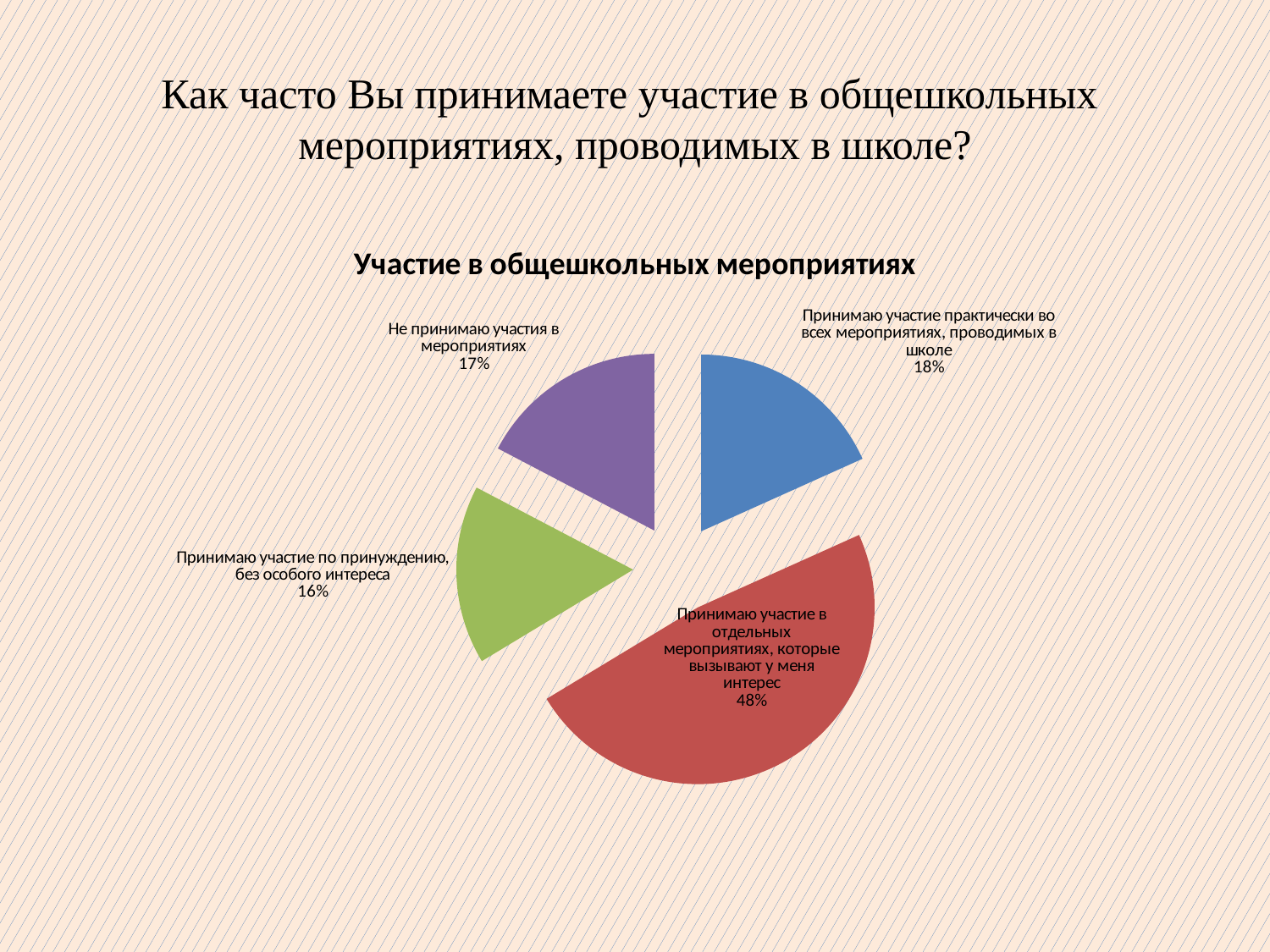
Which category has the largest slice of the pie? Принимаю участие в отдельных мероприятиях, которые вызывают у меня интерес What colour is the slice for "Принимаю участие в отдельных мероприятиях, которые вызывают у меня интерес"? red What kind of chart is shown on the slide? pie chart Which category has the smallest slice of the pie? Принимаю участие по принуждению, без особого интереса What percentage is shown for "Принимаю участие практически во всех мероприятиях, проводимых в школе"? 18% What percentage is shown for "Не принимаю участия в мероприятиях"? 17% How many slices does the pie chart have? 4 What share of the pie is labelled "Принимаю участие в отдельных мероприятиях, которые вызывают у меня интерес"? 48% What is the title of the chart? Участие в общешкольных мероприятиях What percentage is shown for "Принимаю участие по принуждению, без особого интереса"? 16% What is the difference in percentage points between the largest slice (48%) and the "Не принимаю участия в мероприятиях" slice (17%)? 31 Which is larger: the share for "Принимаю участие практически во всех мероприятиях, проводимых в школе" or the share for "Принимаю участие по принуждению, без особого интереса"? Принимаю участие практически во всех мероприятиях, проводимых в школе